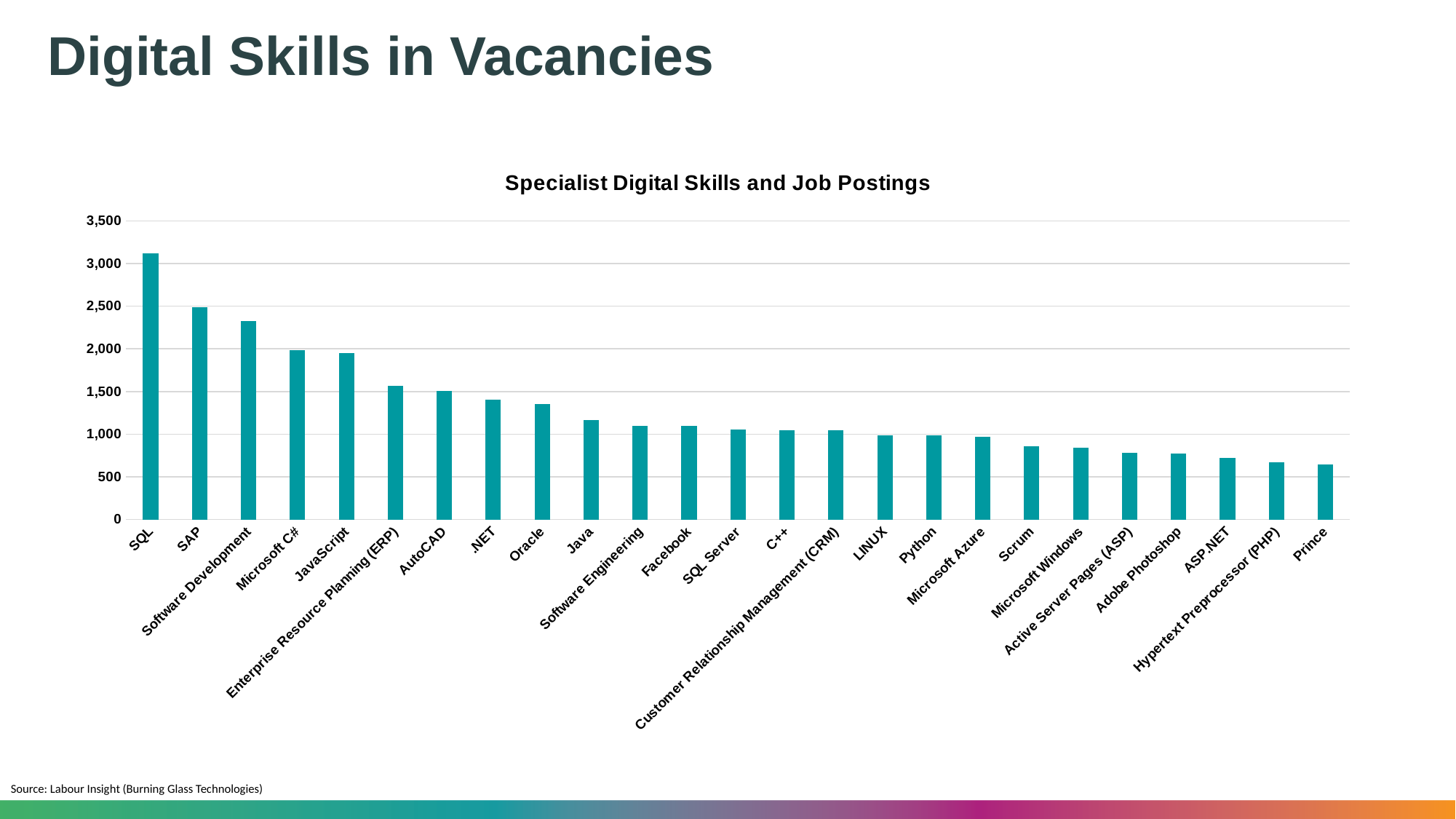
Do the values rise or fall moving from left to right along the x axis? fall Which has more job postings, Oracle or Java? Oracle Which digital skill has the highest number of job postings? SQL Which digital skill has the lowest number of job postings? Prince How many digital skills are plotted on the chart? 25 Is the value for Software Development greater or less than 2,000? greater Is the value for .NET greater or less than 1,500? less What is the title of the chart? Specialist Digital Skills and Job Postings Is the value for Adobe Photoshop greater or less than 1,000? less What kind of chart is shown on the slide? bar chart